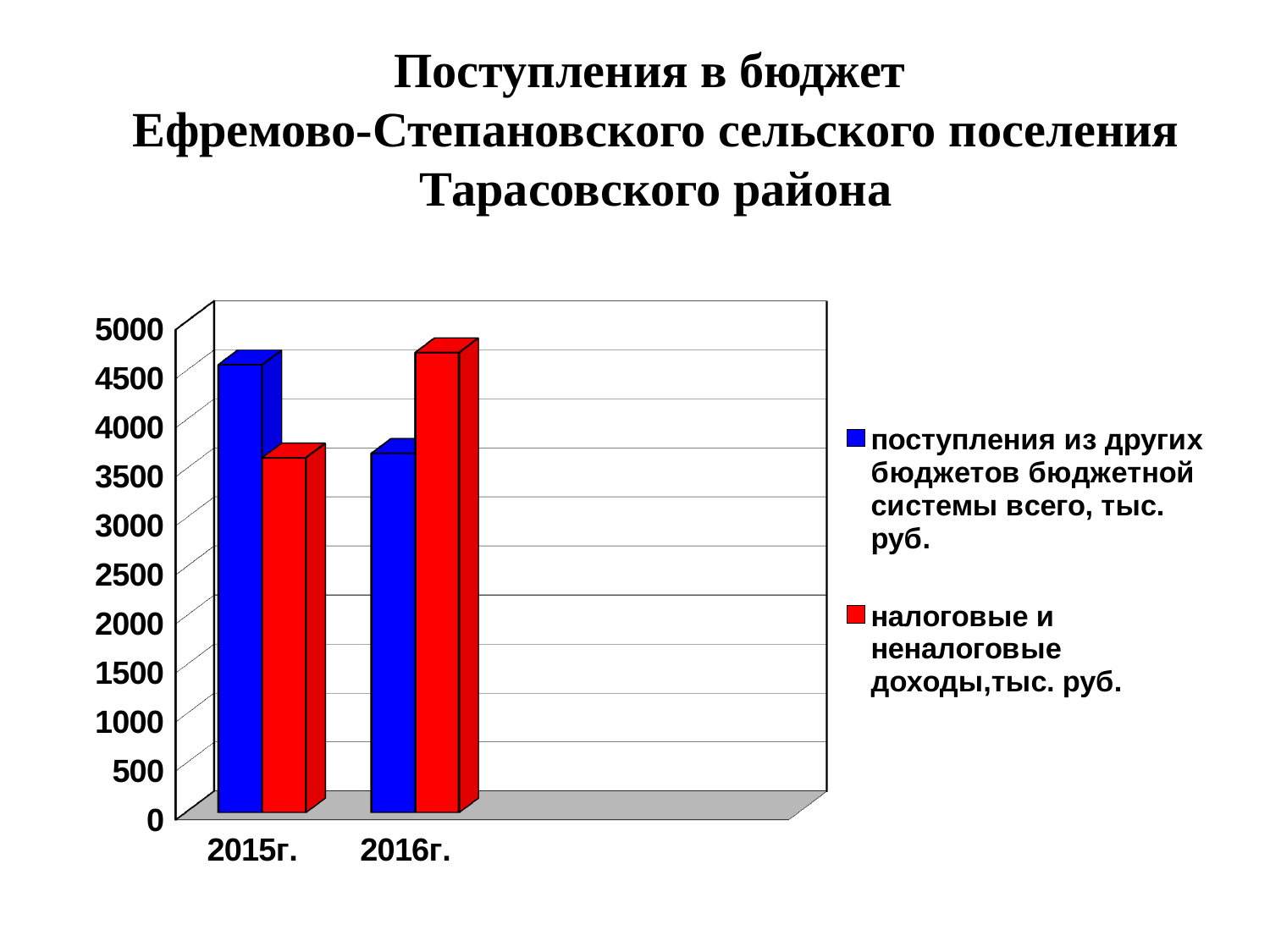
How many series does the legend list? 2 Is the value for "налоговые и неналоговые доходы" in 2015г. greater or less than 4000? less In 2015г., which series has the larger value: "поступления из других бюджетов" or "налоговые и неналоговые доходы"? поступления из других бюджетов бюджетной системы всего Which colour represents "налоговые и неналоговые доходы, тыс. руб." in the legend? red Is the value for "поступления из других бюджетов бюджетной системы всего" in 2016г. greater or less than 4000? less How many years (categories) are shown on the x axis? 2 Does the value for "налоговые и неналоговые доходы" rise or fall from 2015г. to 2016г.? rise Is the value for "налоговые и неналоговые доходы" in 2016г. greater or less than 4500? greater Does the value for "поступления из других бюджетов бюджетной системы всего" rise or fall from 2015г. to 2016г.? fall In 2016г., which series has the larger value: "поступления из других бюджетов" or "налоговые и неналоговые доходы"? налоговые и неналоговые доходы What kind of chart is shown on the slide? bar chart